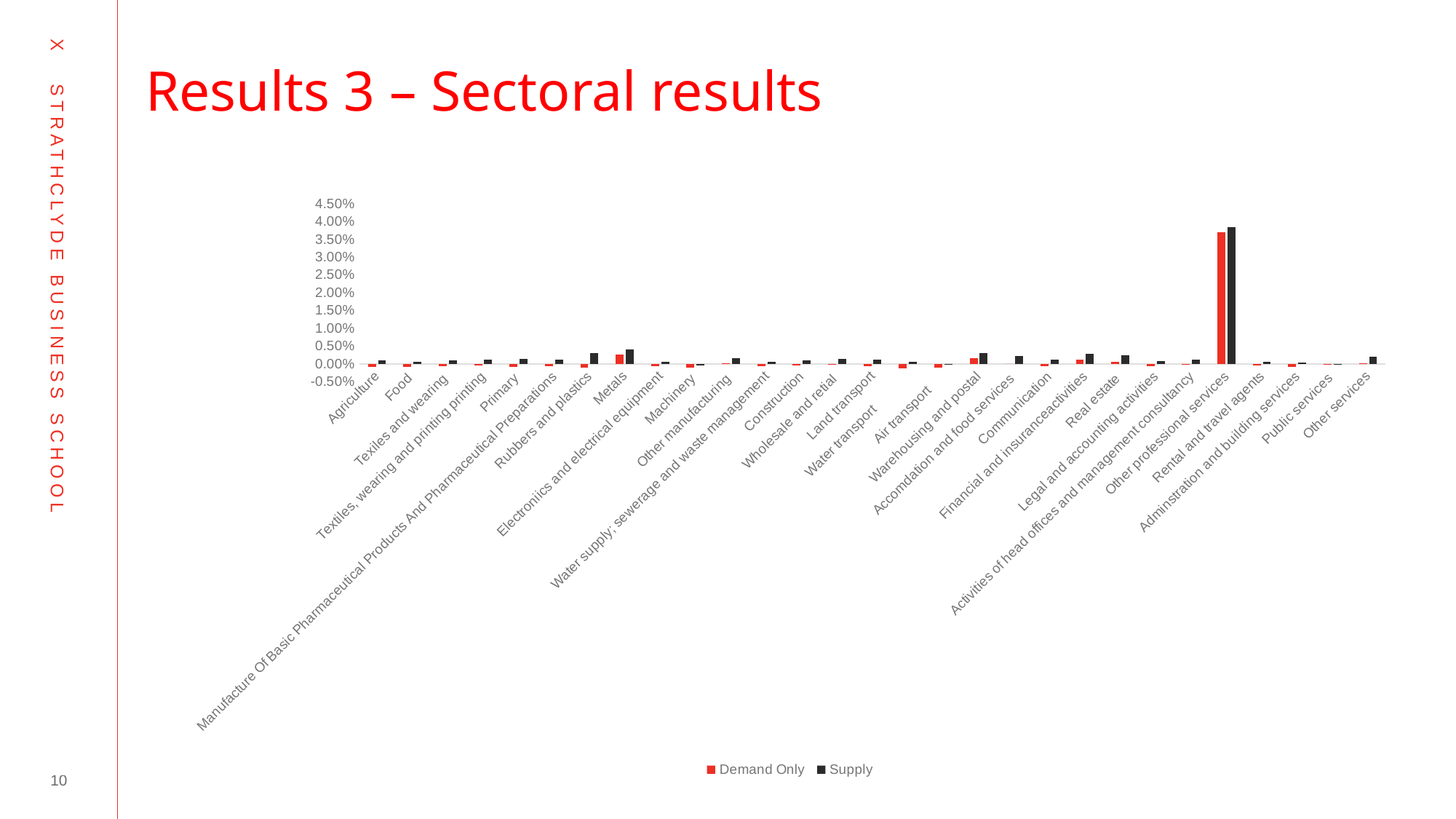
What kind of chart is shown on the slide? bar chart Is the Supply value for Other professional services greater or less than 3.50%? greater Is the Demand Only value for Other professional services greater or less than 3.00%? greater Which is larger: the Supply value for Metals or the Supply value for Agriculture? Metals How many sector categories are shown on the x axis? 29 Which sector has the highest Supply value? Other professional services For Other professional services, which is larger: the Demand Only value or the Supply value? Supply What are the two series named in the legend? Demand Only and Supply How many series does the legend list? 2 Which colour represents the Supply series? black Is the Supply value for Metals greater or less than 1.00%? less Which sector has the highest Demand Only value? Other professional services